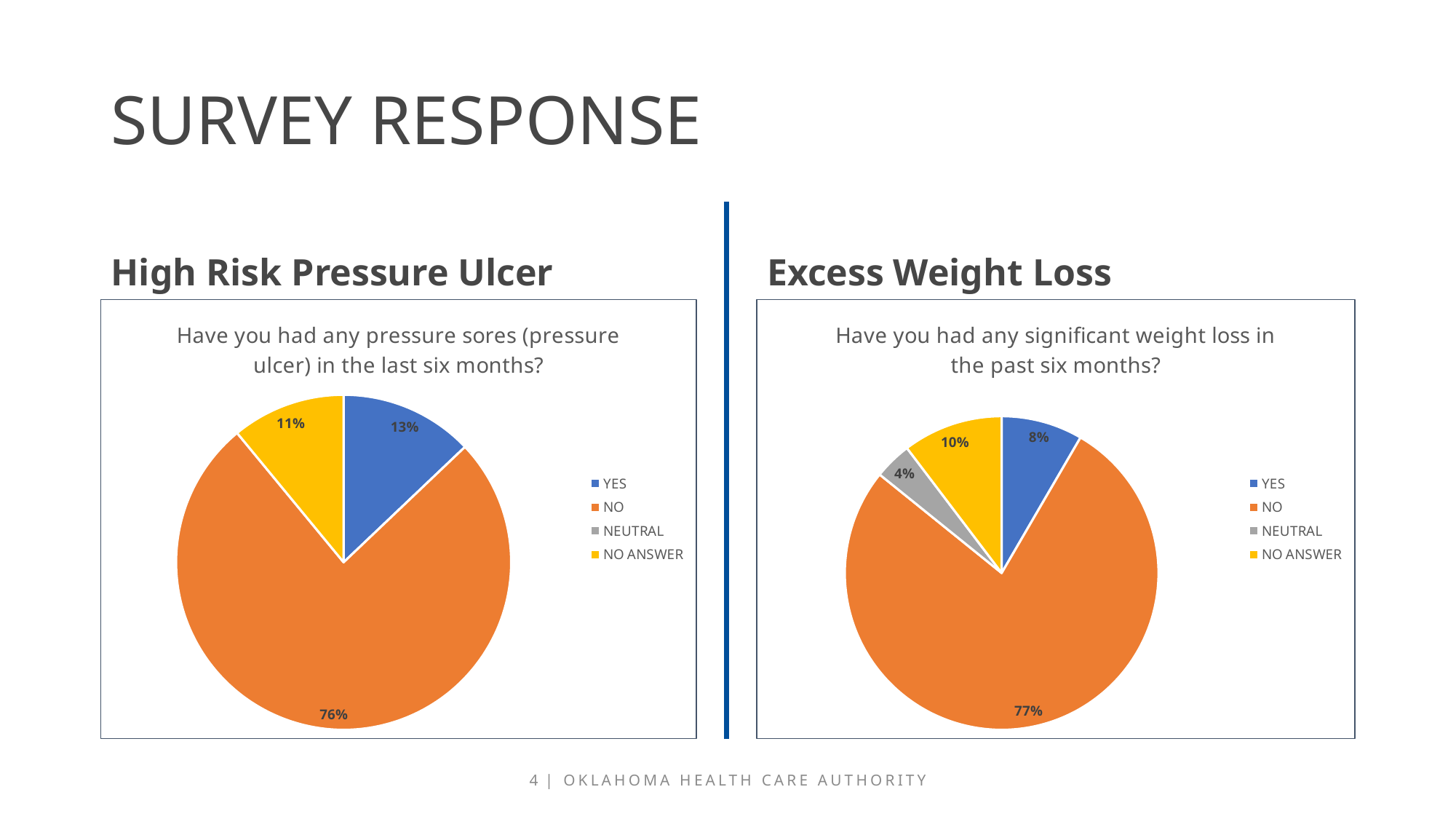
In the High Risk Pressure Ulcer chart, what share of the pie is NO ANSWER? 11% In the Excess Weight Loss chart, which labelled response has the smallest slice? NEUTRAL In the High Risk Pressure Ulcer chart, what percentage of respondents answered NO? 76% In the Excess Weight Loss chart, what share of the pie is NO ANSWER? 10% In the Excess Weight Loss chart, which response has the largest slice? NO In the Excess Weight Loss chart, what percentage of respondents answered YES? 8% In the High Risk Pressure Ulcer chart, what is the difference between the NO and YES percentages? 63% How many entries does the legend of the Excess Weight Loss chart list? 4 What type of chart is used in the High Risk Pressure Ulcer panel? Pie chart Which is larger in the Excess Weight Loss chart: the YES slice or the NO ANSWER slice? NO ANSWER In the High Risk Pressure Ulcer chart, what percentage of respondents answered YES? 13% In the Excess Weight Loss chart, what percentage of respondents answered NEUTRAL? 4%